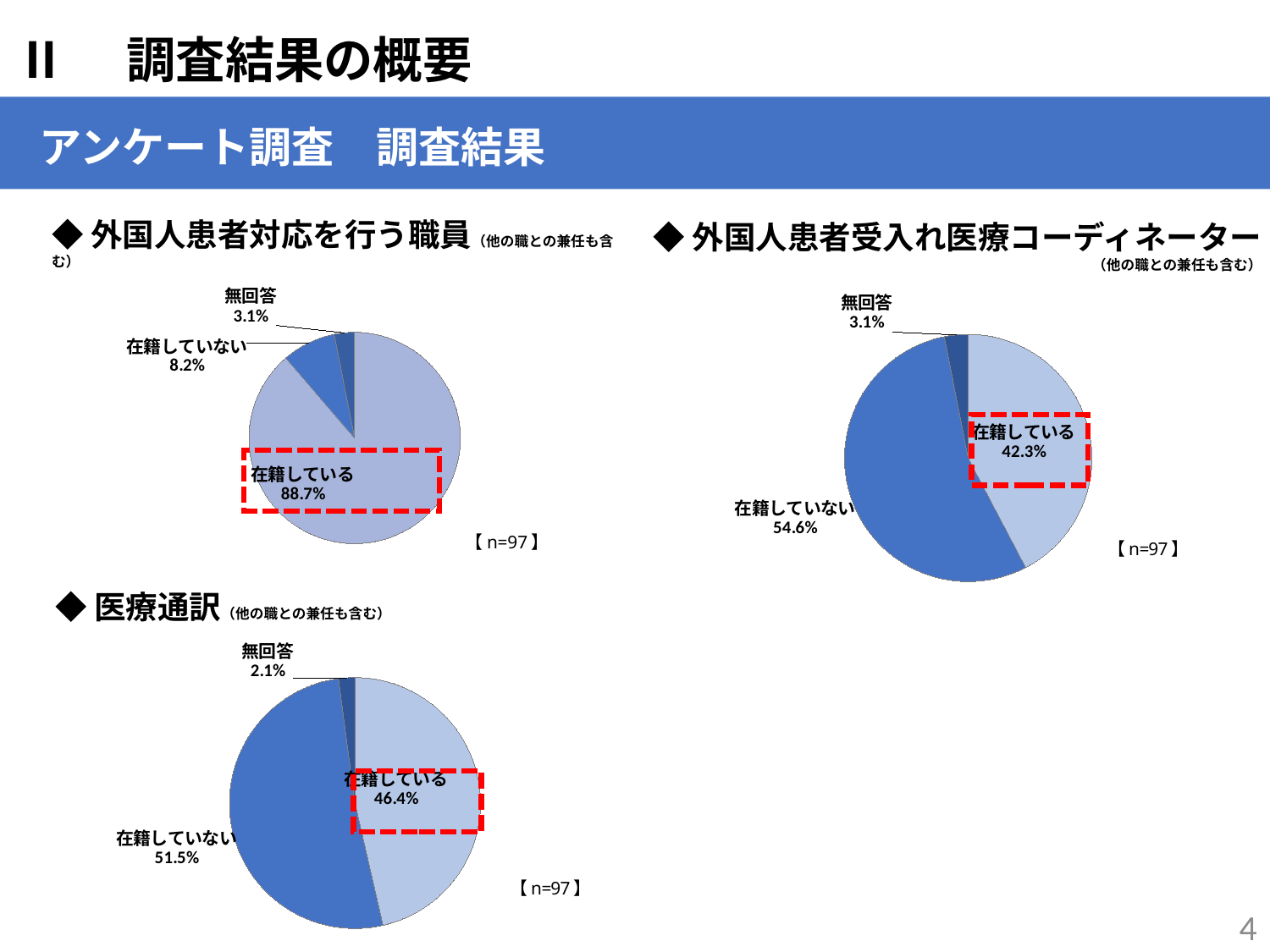
In the 医療通訳 chart, what percentage is 無回答? 2.1% In the 外国人患者受入れ医療コーディネーター chart, what percentage is 在籍している? 42.3% In the 医療通訳 chart, what is the difference between 在籍していない and 在籍している? 5.1% What is the sample size (n) shown for the 外国人患者受入れ医療コーディネーター chart? n=97 What type of chart is used for 外国人患者対応を行う職員? Pie chart In the 外国人患者対応を行う職員 chart, what percentage is 在籍している? 88.7% In the 外国人患者受入れ医療コーディネーター chart, which is larger, 在籍している or 在籍していない? 在籍していない In the 外国人患者対応を行う職員 chart, what percentage is 在籍していない? 8.2% How many slices does the 医療通訳 pie chart have? 3 In the 外国人患者対応を行う職員 chart, which category has the smallest share? 無回答 In the 外国人患者受入れ医療コーディネーター chart, what percentage is 在籍していない? 54.6% In the 医療通訳 chart, which category has the largest share? 在籍していない